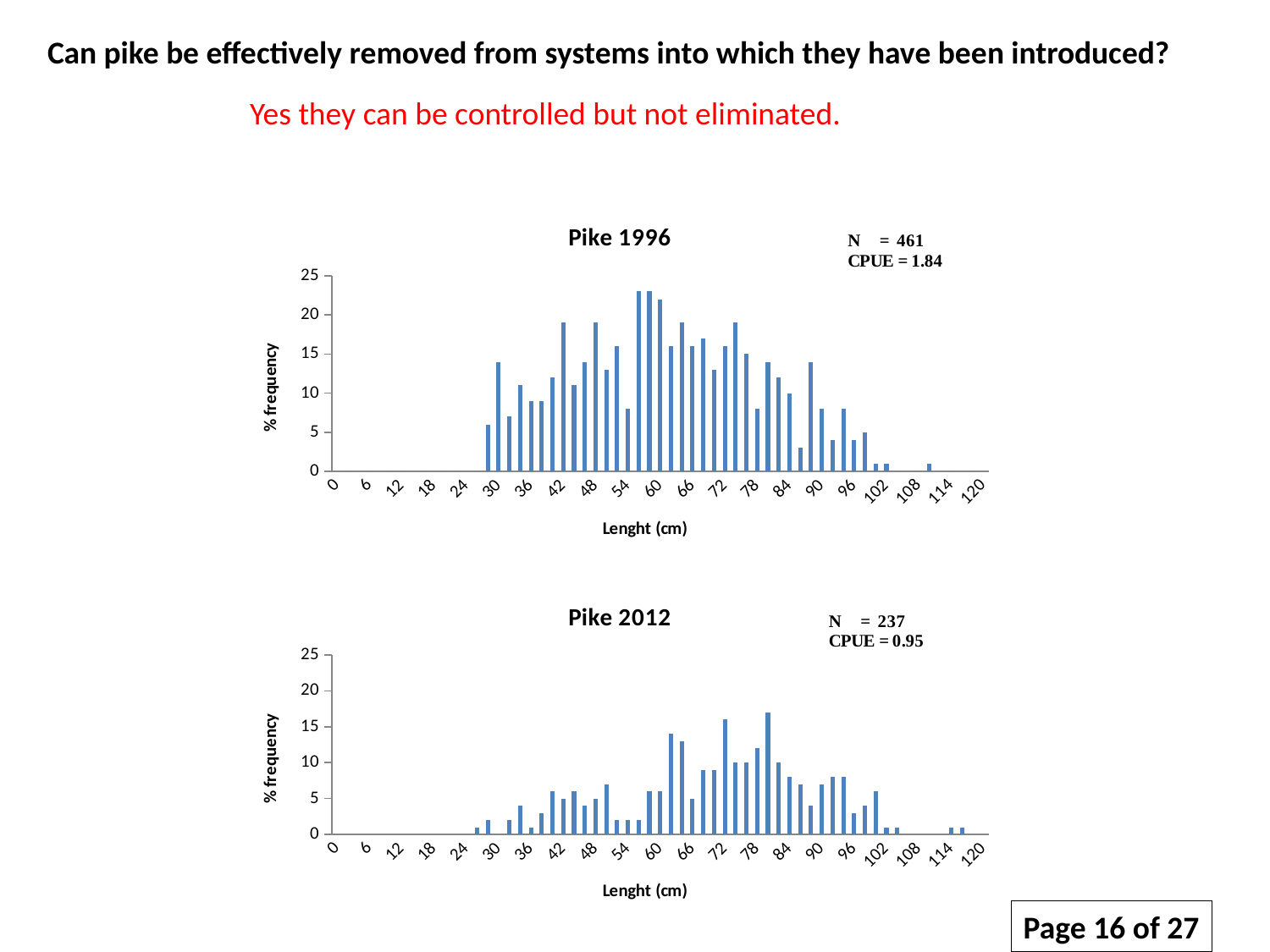
What kind of chart is the Pike 1996 chart? bar chart In the Pike 1996 chart, is the value at 60 cm greater or less than 20? greater In the Pike 1996 chart, do the values rise or fall from 90 cm to 102 cm? fall In the Pike 2012 chart, is the tallest bar greater or less than 20? less In the Pike 1996 chart, is the tallest bar greater or less than 20? greater Which chart has the higher maximum % frequency, Pike 1996 or Pike 2012? Pike 1996 How many length labels are shown on the x axis of the Pike 2012 chart? 21 What is the label on the y axis of the Pike 2012 chart? % frequency What CPUE value is shown on the Pike 1996 chart? 1.84